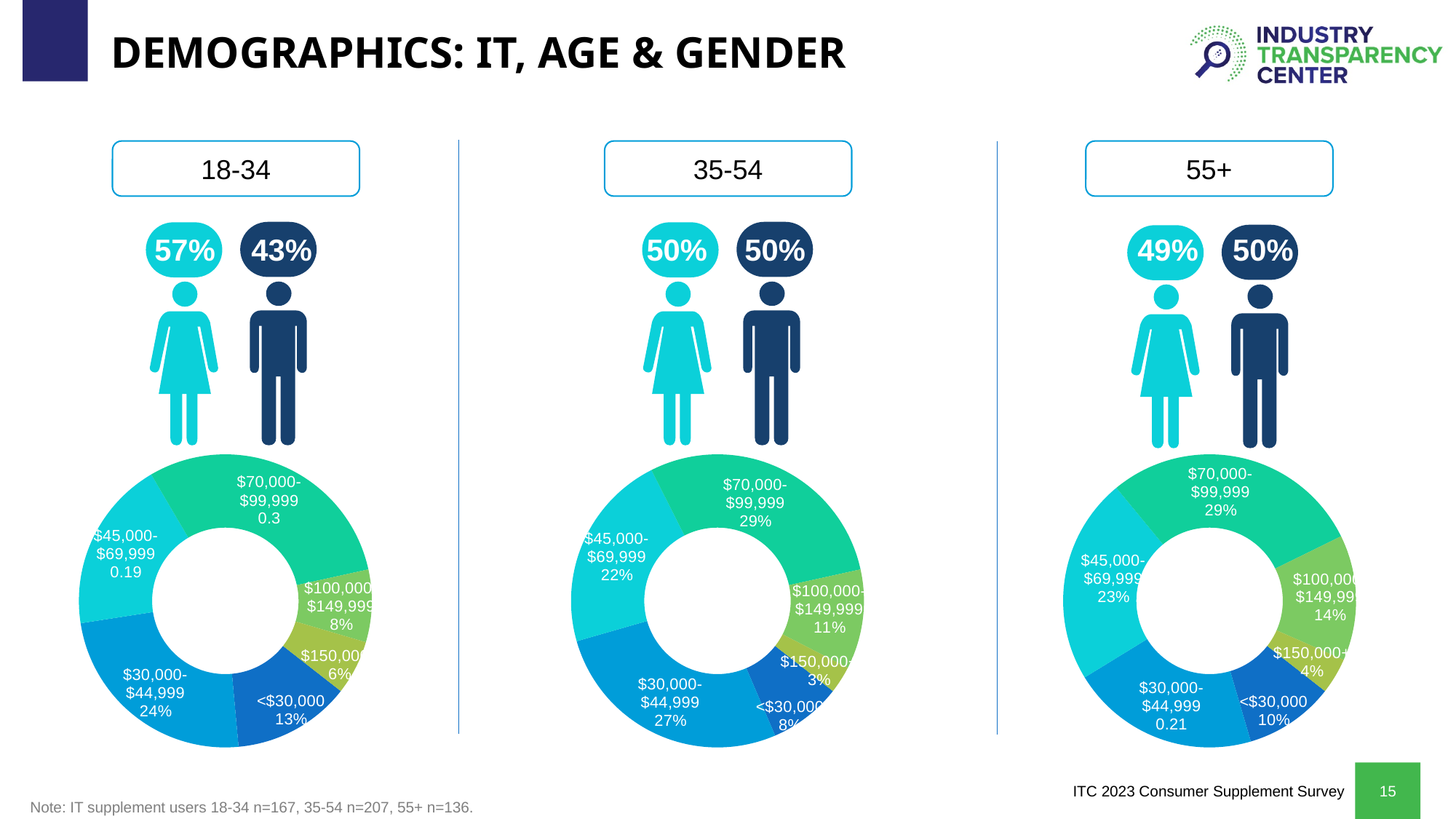
How many income categories does each donut chart show? 6 In the 55+ donut chart, which income category has the largest share? $70,000-$99,999 In the 35-54 donut chart, which income category has the smallest share? $150,000+ What type of chart is used to show income distribution for each age group? Donut (pie) chart In the 55+ donut chart, what is the value for the $100,000-$149,999 slice? 14% How many donut charts are shown on the slide? 3 In the 18-34 donut chart, what value is printed for the $70,000-$99,999 slice? 0.3 In the 35-54 donut chart, what is the difference between the $30,000-$44,999 share and the <$30,000 share? 19% In the 55+ donut chart, which is larger: the <$30,000 slice or the $150,000+ slice? <$30,000 In the 18-34 donut chart, what is the value shown for the $30,000-$44,999 slice? 24% In the 18-34 donut chart, what is the difference between the $100,000-$149,999 share and the $150,000+ share? 2% In the 35-54 donut chart, what is the value for the $45,000-$69,999 slice? 22%